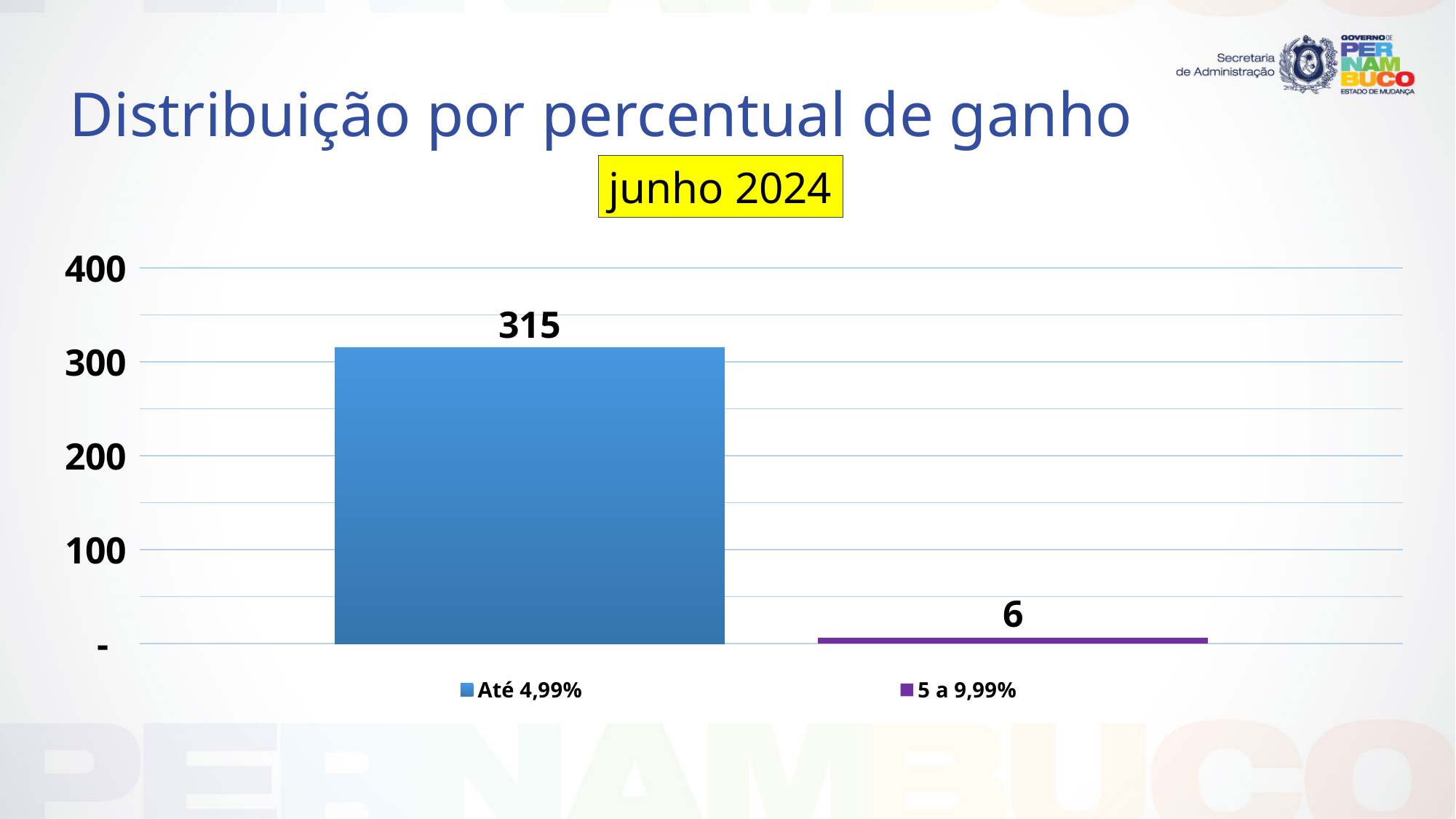
Which category has the highest value? Até 4,99% Is the value for "Até 4,99%" greater or less than 300? greater How many series does the legend list? 2 Which category has the lowest value? 5 a 9,99% What is the total of the two values shown in the chart? 321 What is the value for "5 a 9,99%"? 6 Is the value for "5 a 9,99%" greater or less than 100? less What is the difference between the values for "Até 4,99%" and "5 a 9,99%"? 309 What kind of chart is shown on the slide? Bar chart Which is larger, the value for "Até 4,99%" or the value for "5 a 9,99%"? Até 4,99% What month and year is highlighted in the yellow box above the chart? junho 2024 What is the value for "Até 4,99%"? 315